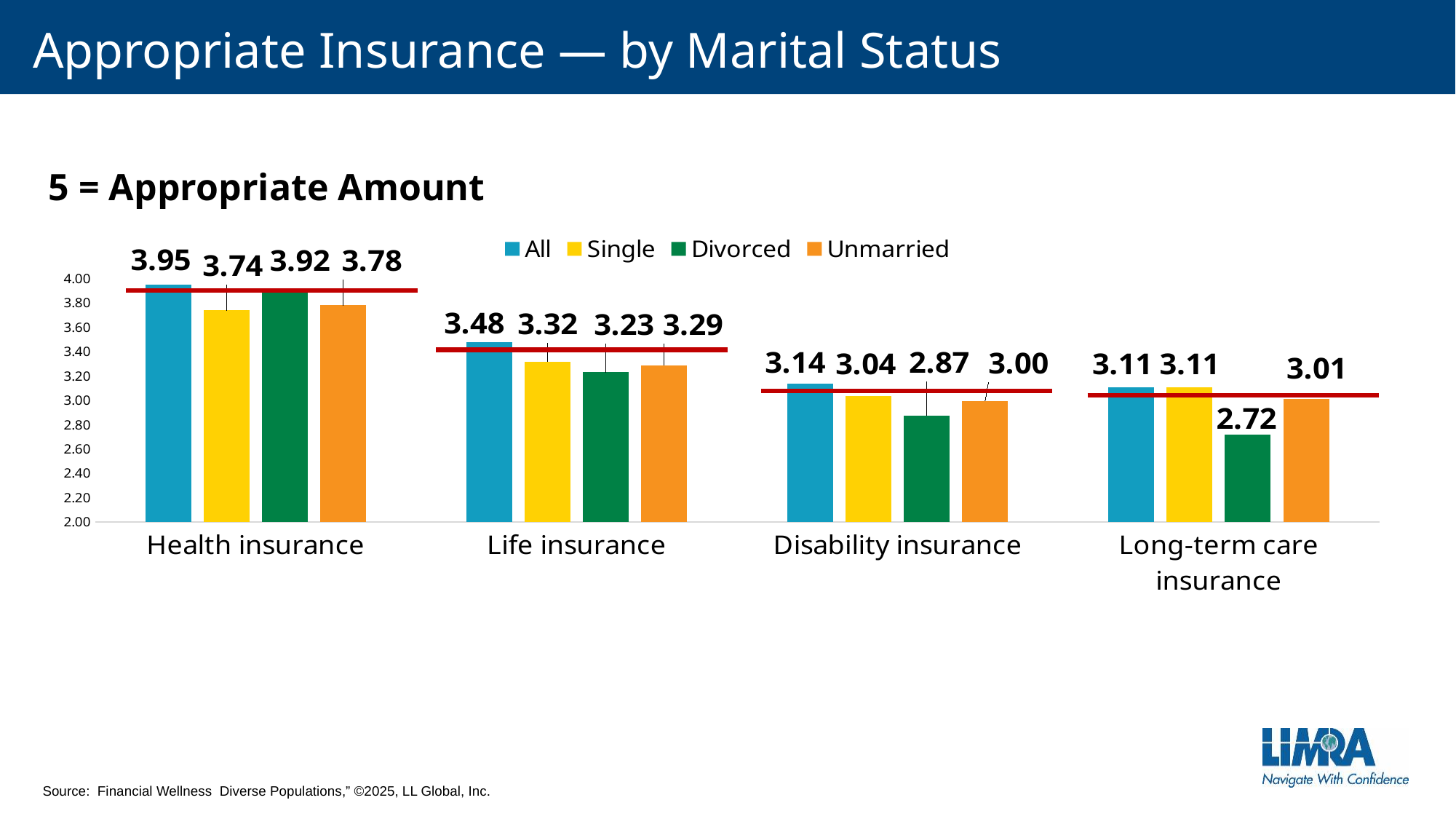
Which colour represents the Divorced series in the legend? Green Which category has the highest value for the All series? Health insurance What is the value for Divorced in the Long-term care insurance category? 2.72 How many insurance categories are shown on the x axis? 4 What is the value for Unmarried in the Disability insurance category? 3.00 Which category has the lowest value for the Divorced series? Long-term care insurance What is the value for Single in the Health insurance category? 3.74 How many series does the legend list? 4 What is the difference between the All value and the Divorced value in the Disability insurance category? 0.27 What is the value for All in the Life insurance category? 3.48 What kind of chart is shown on the slide? Bar chart Which is larger in the Life insurance category: the Single value or the Unmarried value? Single